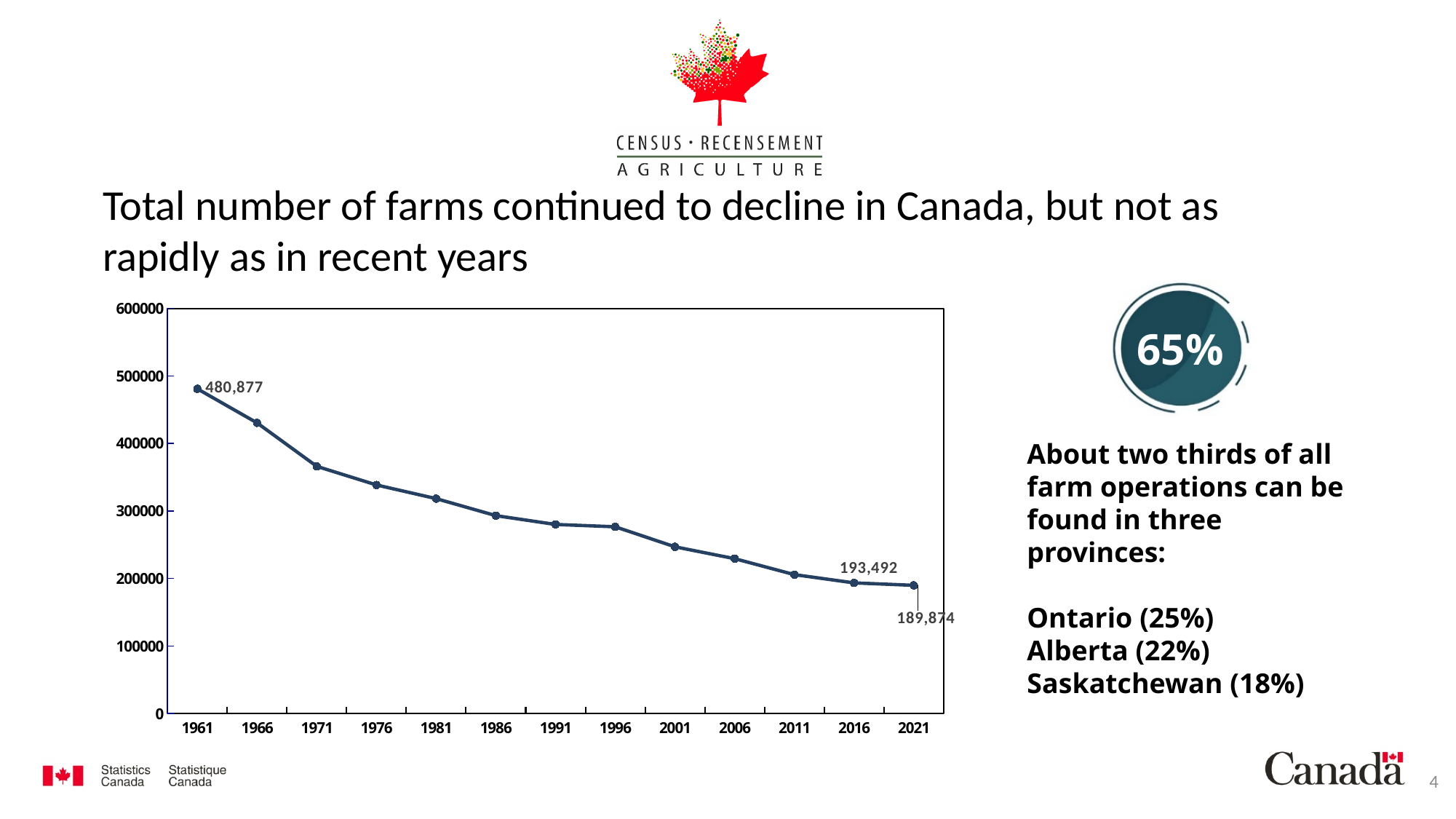
Which year has the lowest number of farms on the chart? 2021 What was the total number of farms in Canada in 2021? 189,874 What was the total number of farms in Canada in 2016? 193,492 Which year has the highest number of farms on the chart? 1961 By how much did the number of farms decrease between 2016 and 2021? 3,618 Does the number of farms rise or fall from 1961 to 2021? fall What type of chart is shown on the slide? line chart How many census years are plotted on the chart? 13 Which year had more farms, 1971 or 1996? 1971 Is the value for 1971 greater or less than 300000? greater What was the total number of farms in Canada in 1961? 480,877 By how much did the number of farms decrease between 1961 and 2021? 291,003